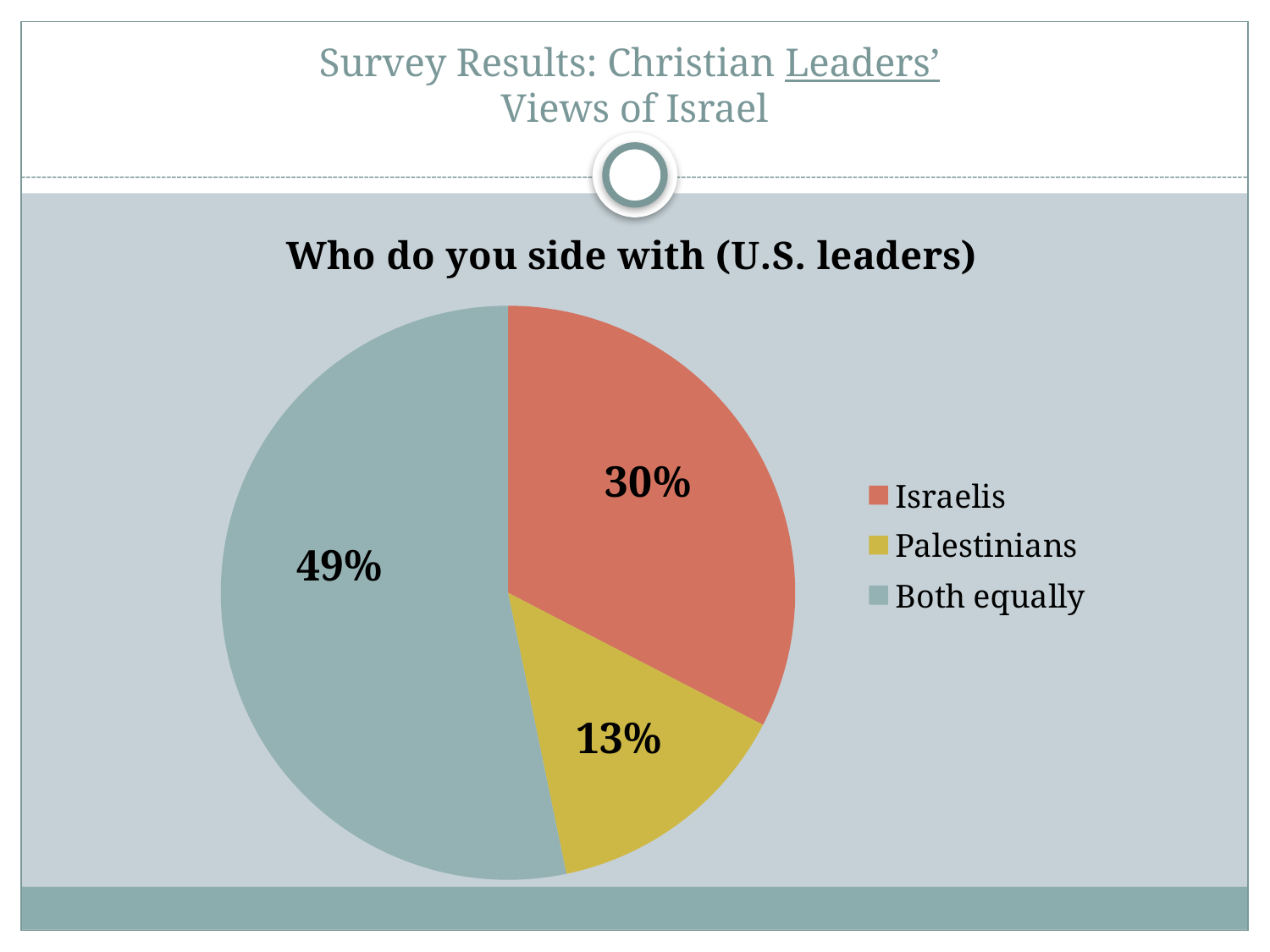
What is the difference in percentage points between the Israelis and Palestinians slices? 17 Which colour represents the Palestinians slice in the legend? Yellow What kind of chart is shown on the slide? Pie chart What is the title of the chart? Who do you side with (U.S. leaders) Which response has the smallest share of the pie? Palestinians What percentage of U.S. leaders side with the Palestinians? 13% What percentage of U.S. leaders side with the Israelis? 30% What percentage of U.S. leaders side with both equally? 49% How many slices does the pie chart have? 3 Which response has the largest share of the pie? Both equally Which is larger, the share for Israelis or the share for Palestinians? Israelis What is the difference in percentage points between the Both equally and Israelis slices? 19